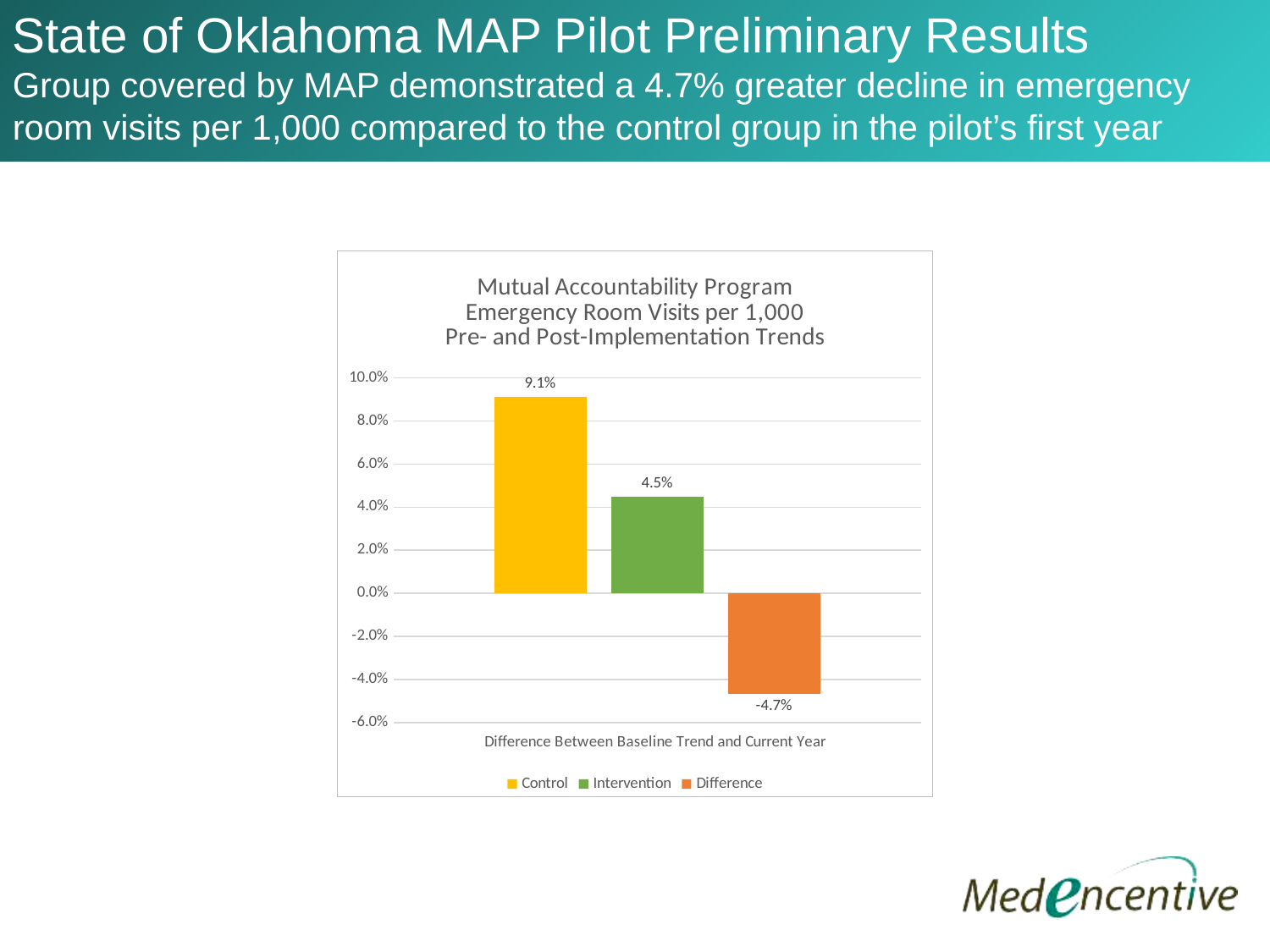
What kind of chart is shown? Bar chart What colour is the Difference bar? Orange Which series has the highest value? Control What is the value for Difference? -4.7% Which series has the lowest value? Difference What is the value for Control? 9.1% Is the value for Difference greater or less than -4.0%? less What is the value for Intervention? 4.5% Is the value for Control greater or less than 8.0%? greater How many series does the legend list? 3 Which is larger, the Control value or the Intervention value? Control What is the difference between the Control value and the Intervention value? 4.6%